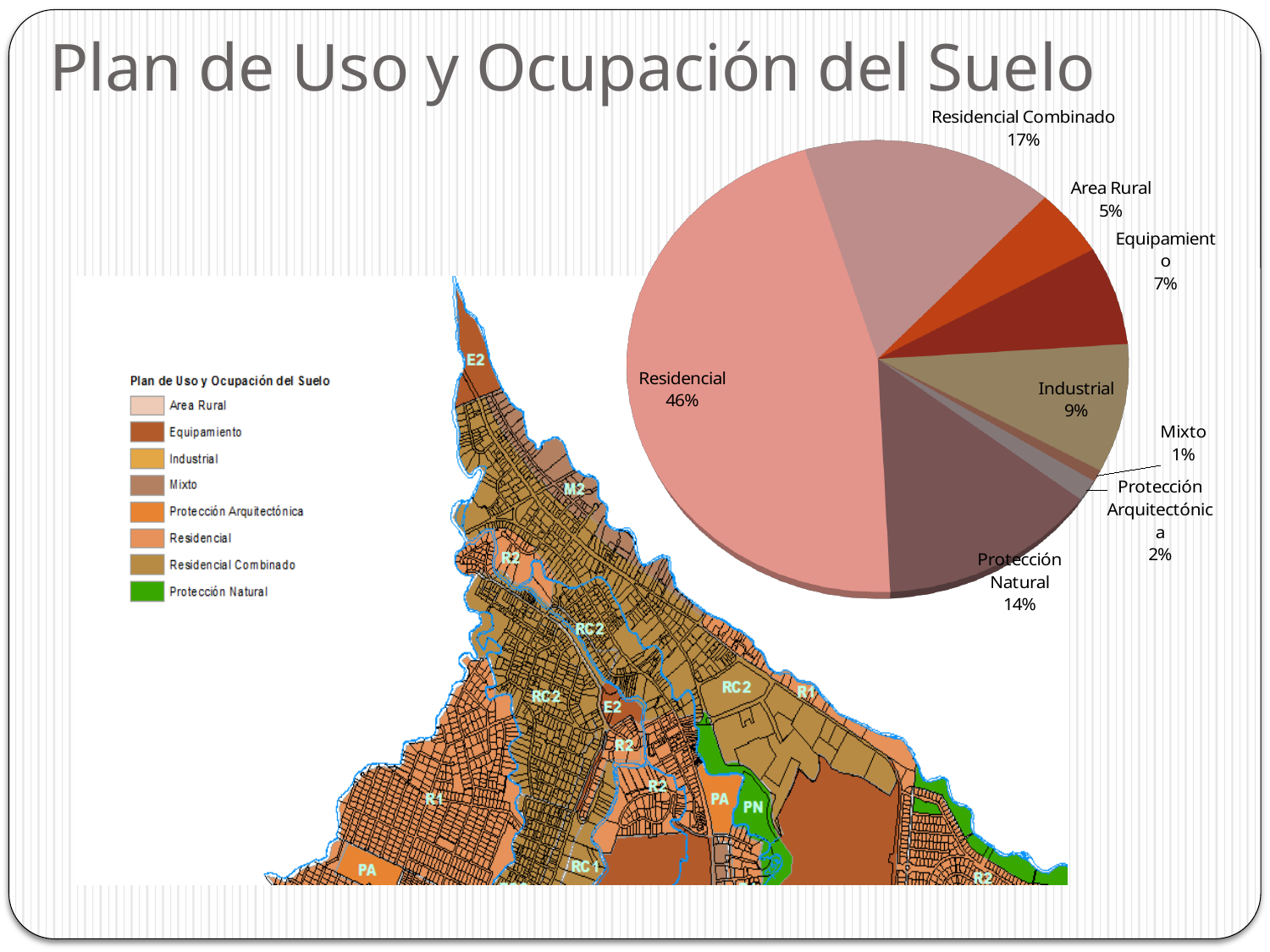
What is the difference in percentage points between Industrial and Equipamiento in the pie chart? 2 Which category has the smallest slice in the pie chart? Mixto Which is larger in the pie chart, Protección Natural or Industrial? Protección Natural What percentage is shown for Protección Natural in the pie chart? 14% Which is larger in the pie chart, Area Rural or Equipamiento? Equipamiento How many slices does the pie chart have? 8 What share of the pie chart does Residencial represent? 46% What percentage is shown for Residencial Combinado in the pie chart? 17% Which category has the largest slice in the pie chart? Residencial What is the difference in percentage points between Residencial and Residencial Combinado in the pie chart? 29 What percentage is shown for Industrial in the pie chart? 9% What type of chart is shown on the slide? Pie chart